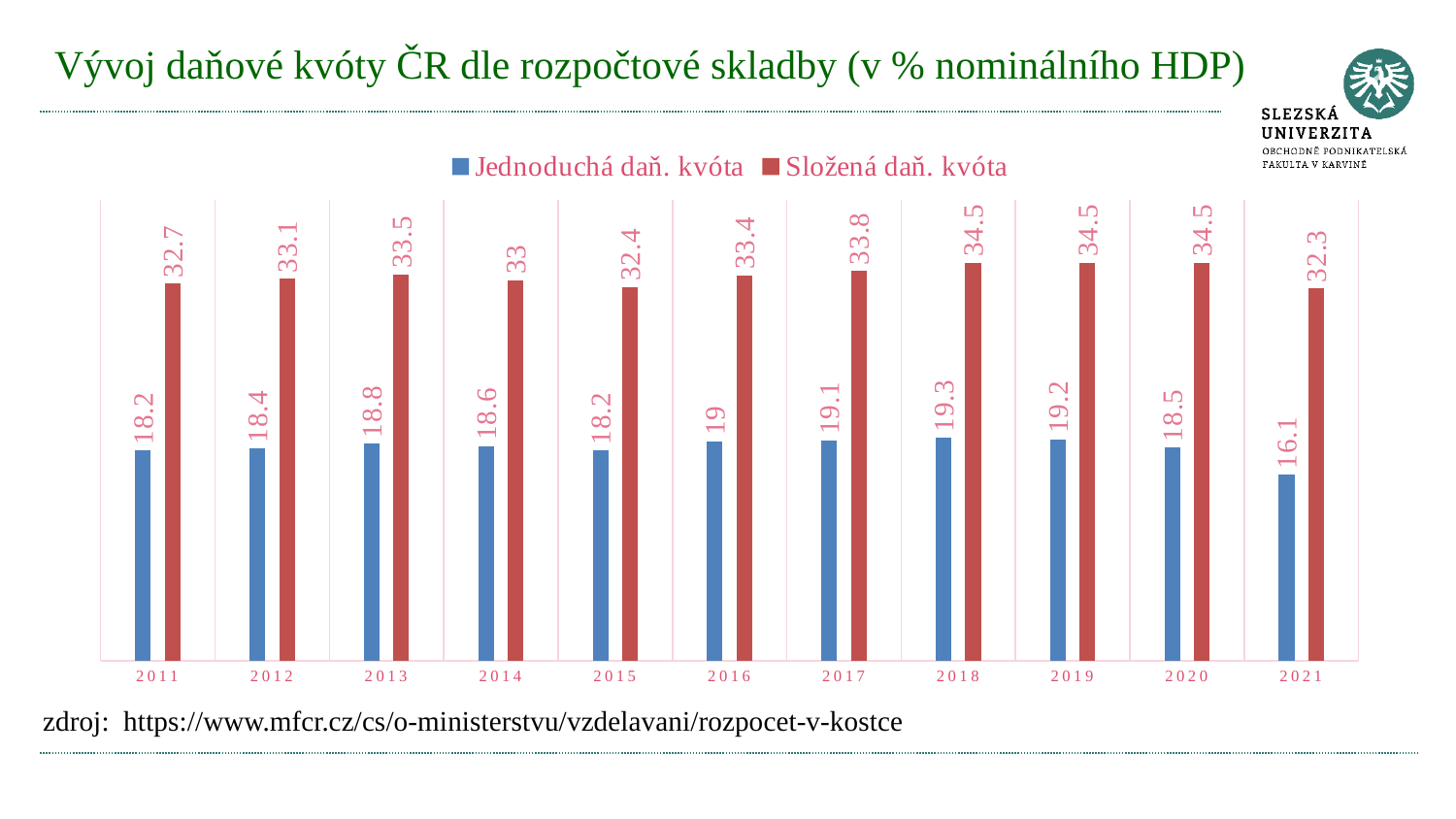
What is the value of Jednoduchá daň. kvóta in 2018? 19.3 In which year is Jednoduchá daň. kvóta the lowest? 2021 How many series does the legend list? 2 What is the difference between Složená daň. kvóta and Jednoduchá daň. kvóta in 2011? 14.5 In which year is Jednoduchá daň. kvóta the highest? 2018 What is the value of Složená daň. kvóta in 2015? 32.4 What is the value of Jednoduchá daň. kvóta in 2021? 16.1 How many years are shown on the x axis? 11 Which colour represents Složená daň. kvóta in the chart? Red Which is larger: Složená daň. kvóta in 2013 or Složená daň. kvóta in 2014? 2013 What kind of chart is shown on the slide? Bar chart In which year is Složená daň. kvóta the lowest? 2021